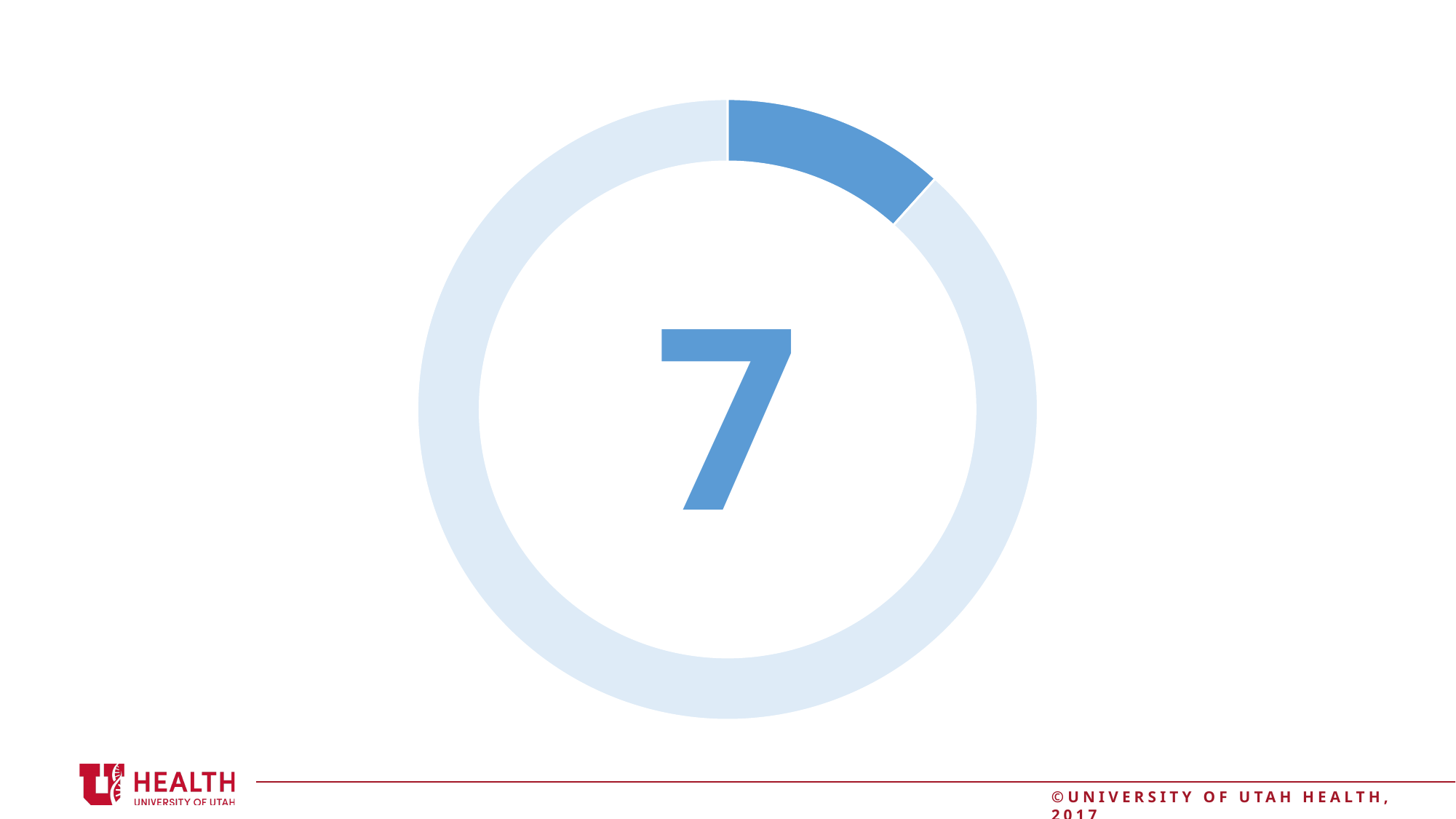
How many segments does the doughnut chart have? 2 Does the dark blue segment cover more or less than half of the ring? Less What number is printed in the centre of the doughnut chart? 7 What colour is the highlighted (filled) segment of the doughnut chart? Blue What kind of chart is shown on the slide? Doughnut chart Does the doughnut chart have a legend? No Which segment of the doughnut chart is larger, the dark blue one or the light blue one? The light blue one